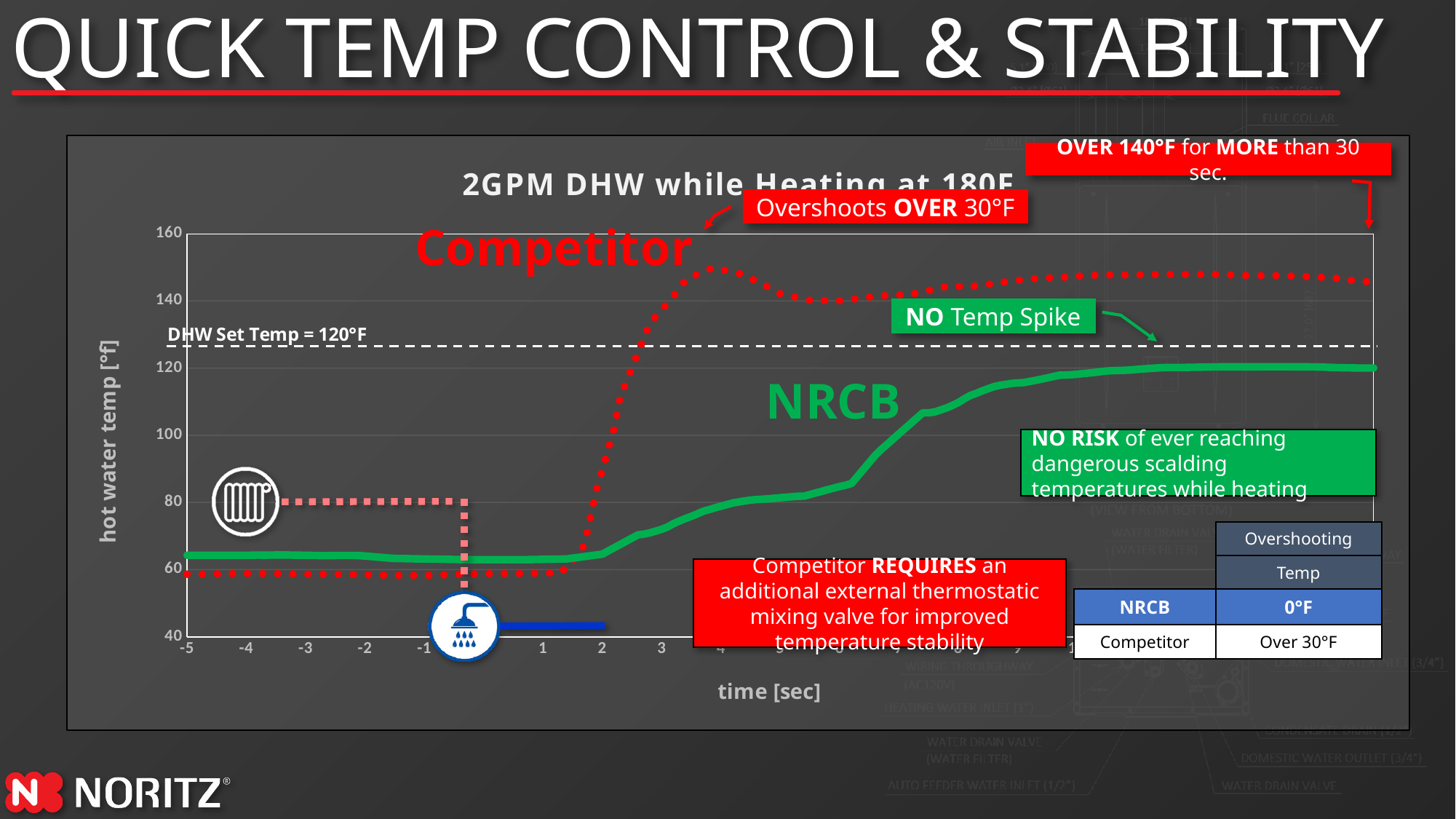
Is the value of the NRCB series at the right end of the chart greater or less than 140? less What kind of chart is shown on the slide? line chart Does the NRCB series rise or fall as time increases from 0 to 10 sec? rise What is the label of the x axis of the chart? time [sec] Is the peak value of the Competitor series greater or less than 140? greater How many data series are plotted on the chart? 2 Is the value of the Competitor series at time -5 greater or less than 80? less Which series reaches the highest hot water temperature on the chart? Competitor At time 4 sec, which series has the higher hot water temperature, Competitor or NRCB? Competitor What DHW set temperature is marked by the dashed line on the chart? 120°F